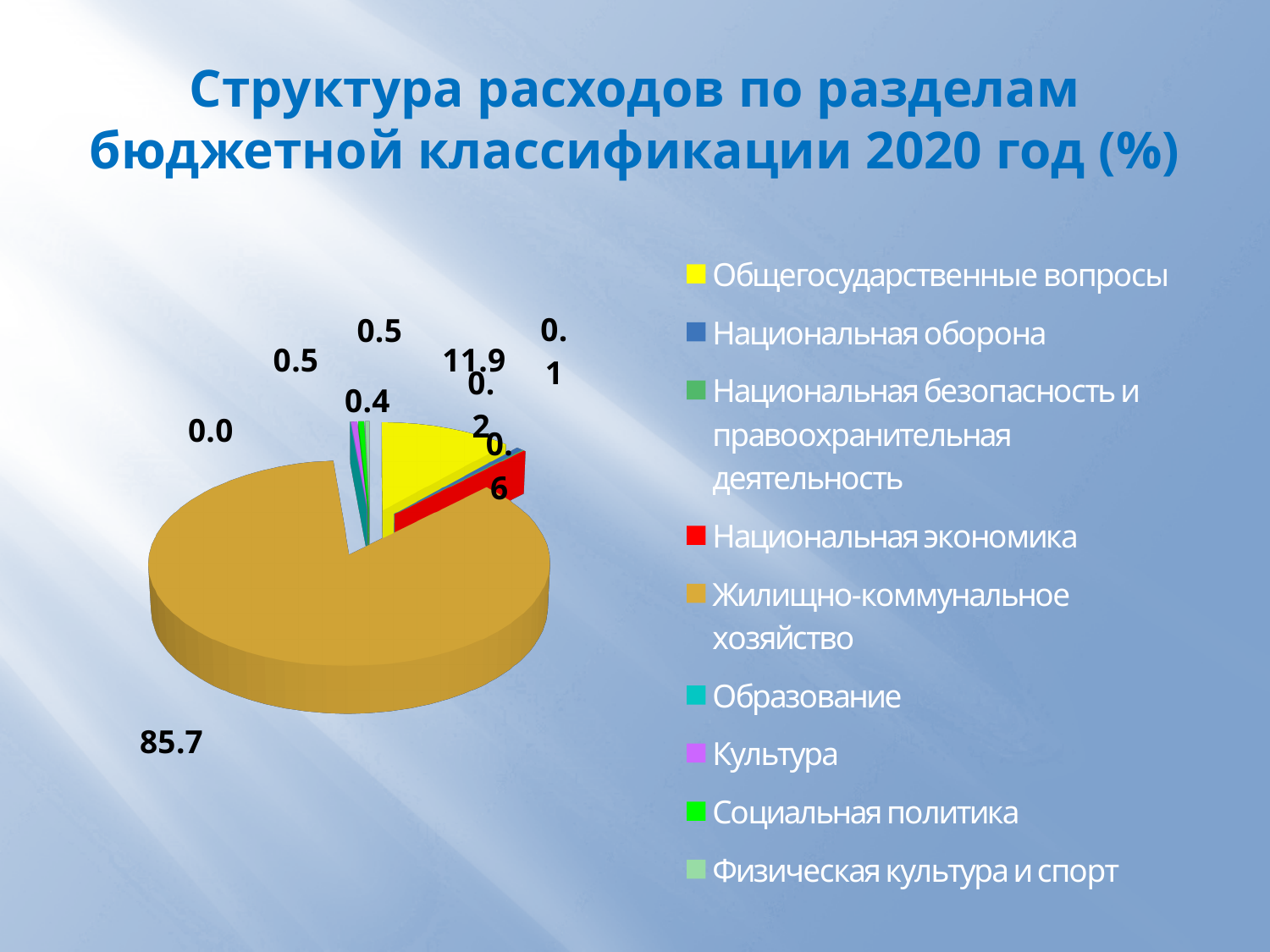
What value is shown for Жилищно-коммунальное хозяйство? 85.7 Which category has the largest slice in the pie chart? Жилищно-коммунальное хозяйство What is the difference between the values for Жилищно-коммунальное хозяйство and Общегосударственные вопросы? 73.8 Is the value for Общегосударственные вопросы greater or less than 50? less Which is larger, the slice for Общегосударственные вопросы or the slice for Жилищно-коммунальное хозяйство? Жилищно-коммунальное хозяйство How many data labels are printed around the pie chart? 9 What colour represents Национальная экономика in the legend? red What value is shown for Национальная экономика? 0.2 What kind of chart is shown on the slide? pie chart How many categories does the legend of the pie chart list? 9 What is the title of the chart on the slide? Структура расходов по разделам бюджетной классификации 2020 год (%) What value is shown for Общегосударственные вопросы? 11.9